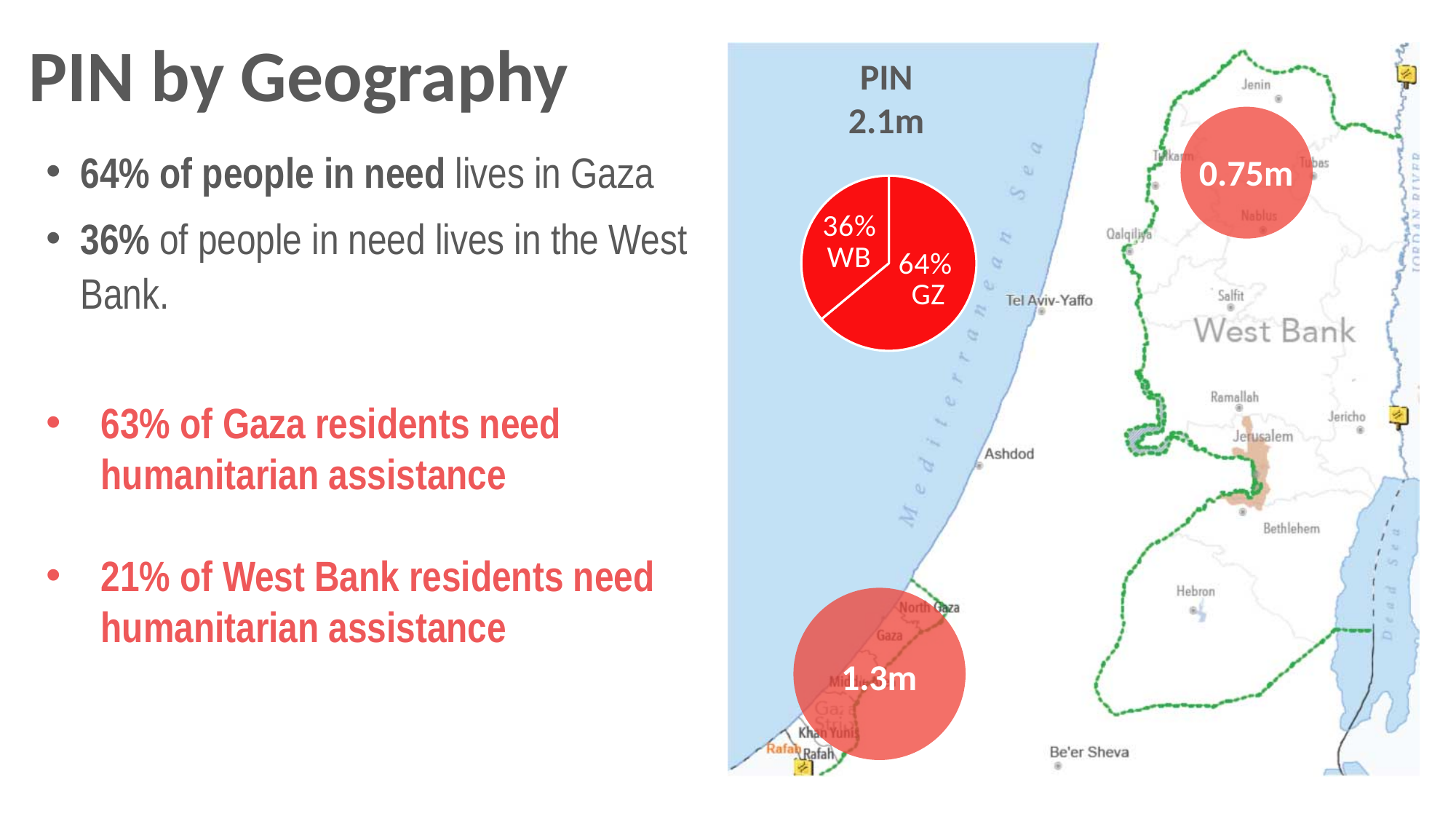
How many slices does the pie chart have? 2 Which slice of the pie chart is the largest? GZ Which is larger in the pie chart, the WB slice or the GZ slice? GZ What is the title shown above the pie chart? PIN 2.1m What share of the pie chart is labelled GZ? 64% On the map, what value is shown in the bubble over the West Bank? 0.75m What colour are the slices of the pie chart? red On the map, what value is shown in the bubble over Gaza? 1.3m What is the difference in percentage points between the GZ and WB slices of the pie chart? 28 What share of the pie chart is labelled WB? 36% Which slice of the pie chart is the smallest? WB What kind of chart is shown on the slide? pie chart